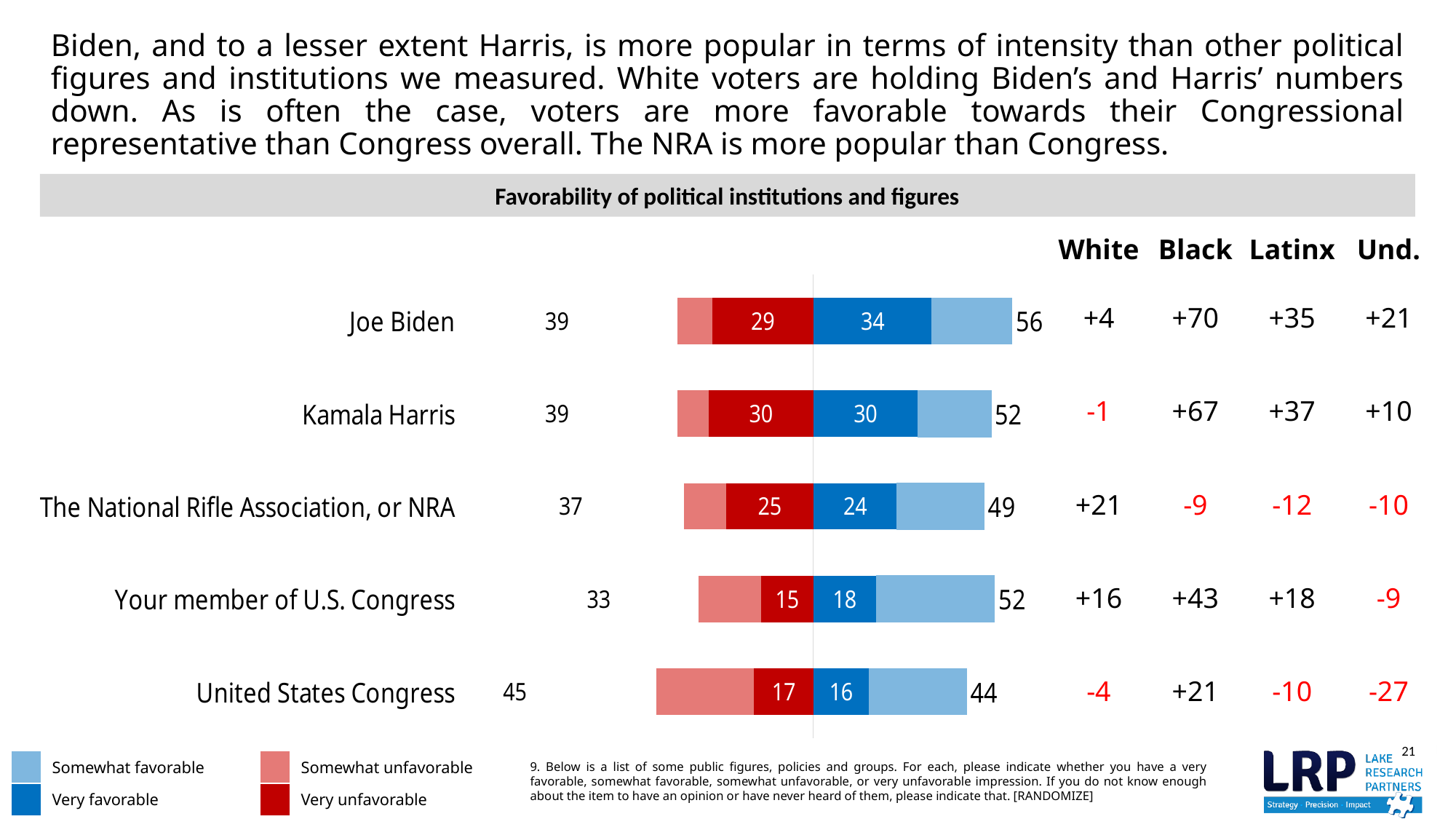
Who has the larger very favorable value, Joe Biden or Kamala Harris? Joe Biden What is the very favorable value shown for Your member of U.S. Congress? 18 How many series does the legend list? 4 Which category has the highest total favorable value? Joe Biden What is the difference between Joe Biden's total favorable (56) and total unfavorable (39) values? 17 Which category has the lowest total favorable value? United States Congress Which category has the highest total unfavorable value? United States Congress What is the title of the chart? Favorability of political institutions and figures What is the very unfavorable value shown for Kamala Harris? 30 How many political figures and institutions are shown in the chart? 5 What kind of chart is shown on the slide? Bar chart What is the total favorable value shown for Joe Biden? 56